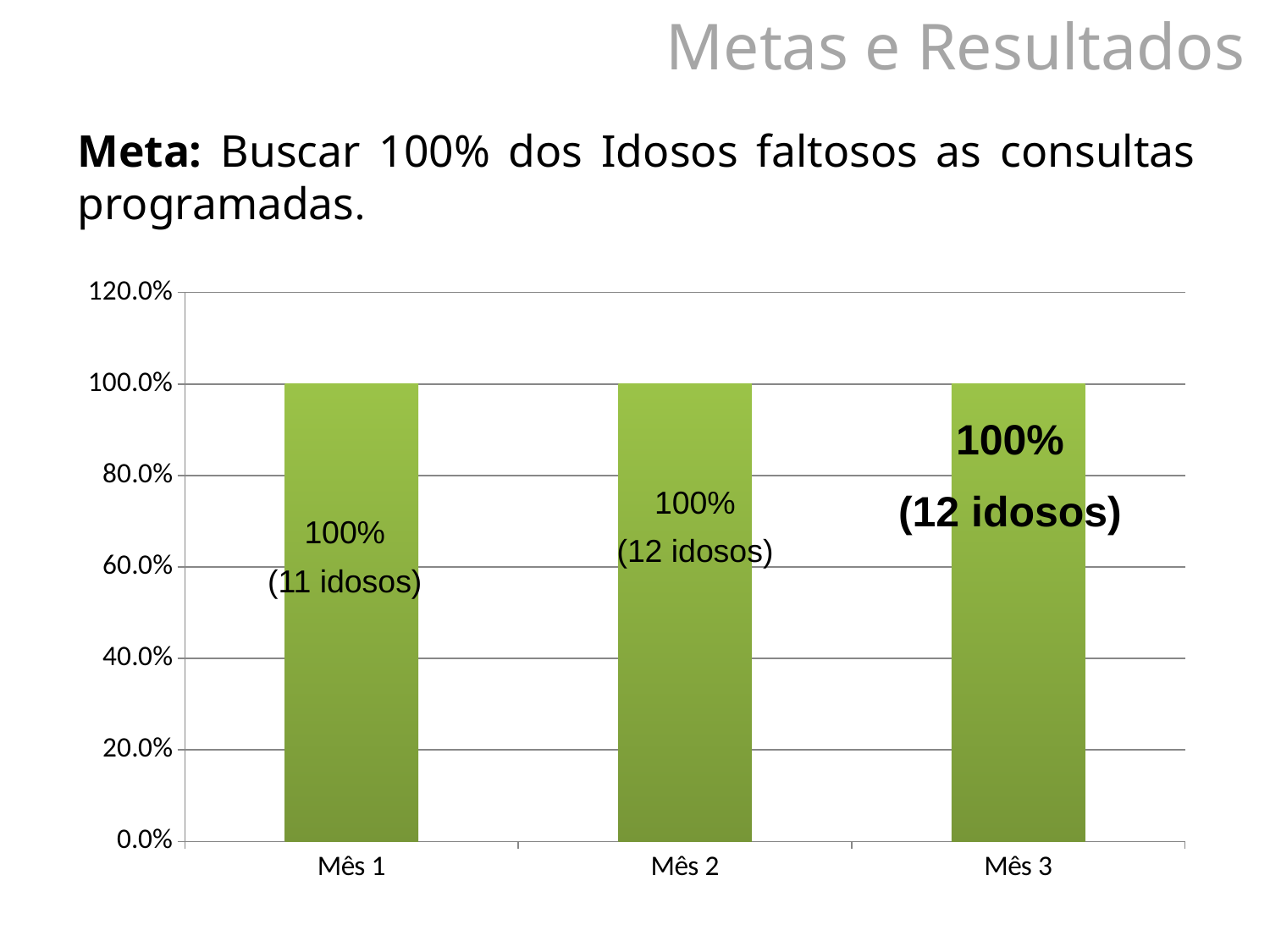
What kind of chart is shown on the slide? bar chart How many idosos does the label for Mês 3 indicate? 12 idosos What is the value for Mês 1? 100% What is the value for Mês 3? 100% What is the value for Mês 2? 100% How many categories are shown on the x axis? 3 What colour are the bars in the chart? green What is the highest value shown on the y axis? 120.0% Is the value for Mês 2 greater or less than 80.0%? greater What is the difference between the values for Mês 2 and Mês 1? 0% Do the values rise, fall or stay the same from Mês 1 to Mês 3? stay the same How many idosos does the label for Mês 1 indicate? 11 idosos